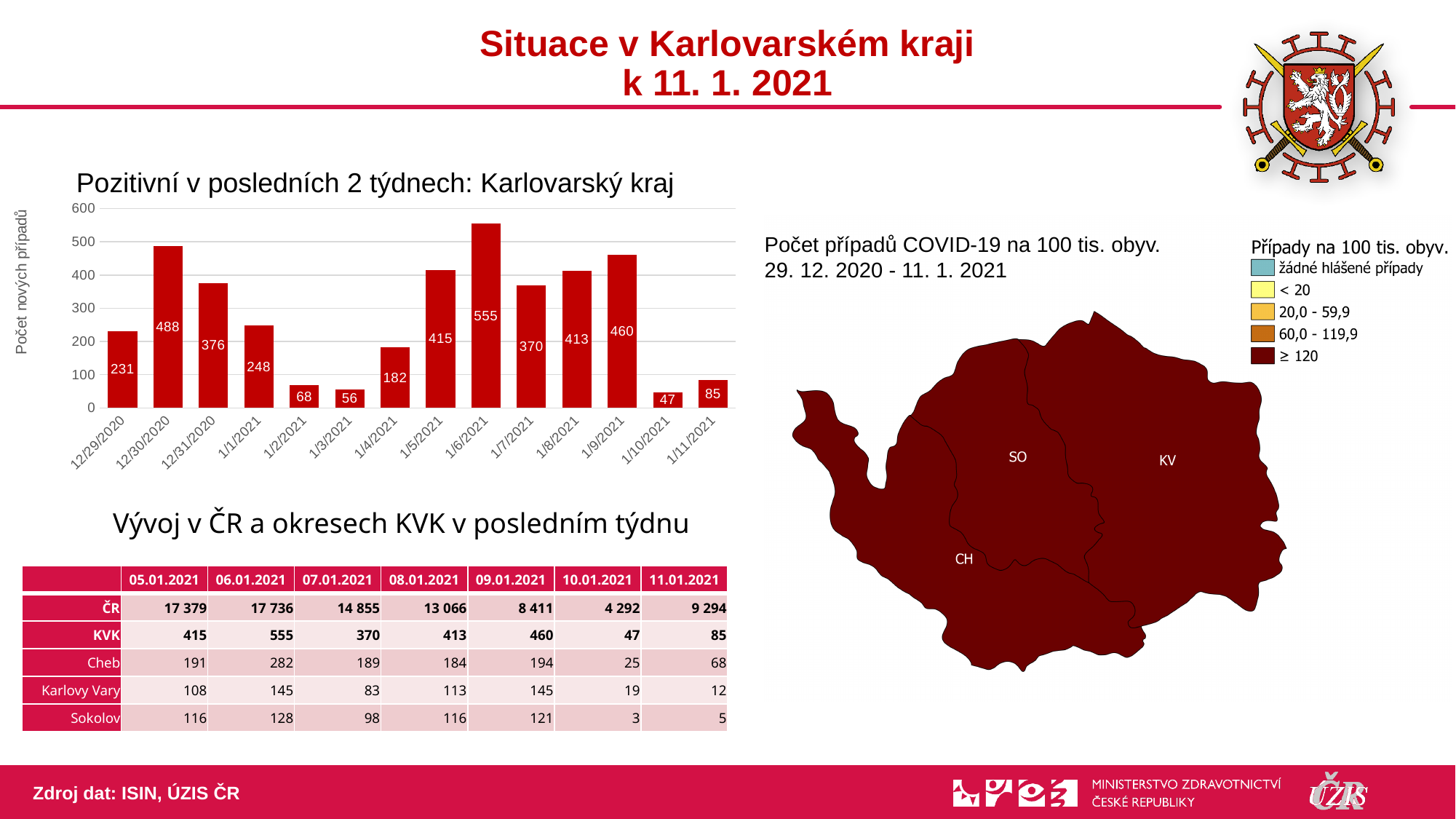
Which date has the lowest value in the bar chart? 1/10/2021 Which is larger in the bar chart, the value for 1/5/2021 or the value for 1/9/2021? 1/9/2021 Is the value for 1/8/2021 in the bar chart greater or less than 400? greater What is the value for 1/4/2021 in the bar chart? 182 What is the value for 12/30/2020 in the bar chart? 488 What is the difference between the values for 1/6/2021 and 1/7/2021 in the bar chart? 185 What is the value for 1/11/2021 in the bar chart? 85 What is the title of the bar chart? Pozitivní v posledních 2 týdnech: Karlovarský kraj What type of chart is used to show positive cases in the last 2 weeks? bar chart Which date has the highest value in the bar chart? 1/6/2021 How many dates (bars) are shown in the bar chart? 14 What is the difference between the values for 12/29/2020 and 12/30/2020 in the bar chart? 257